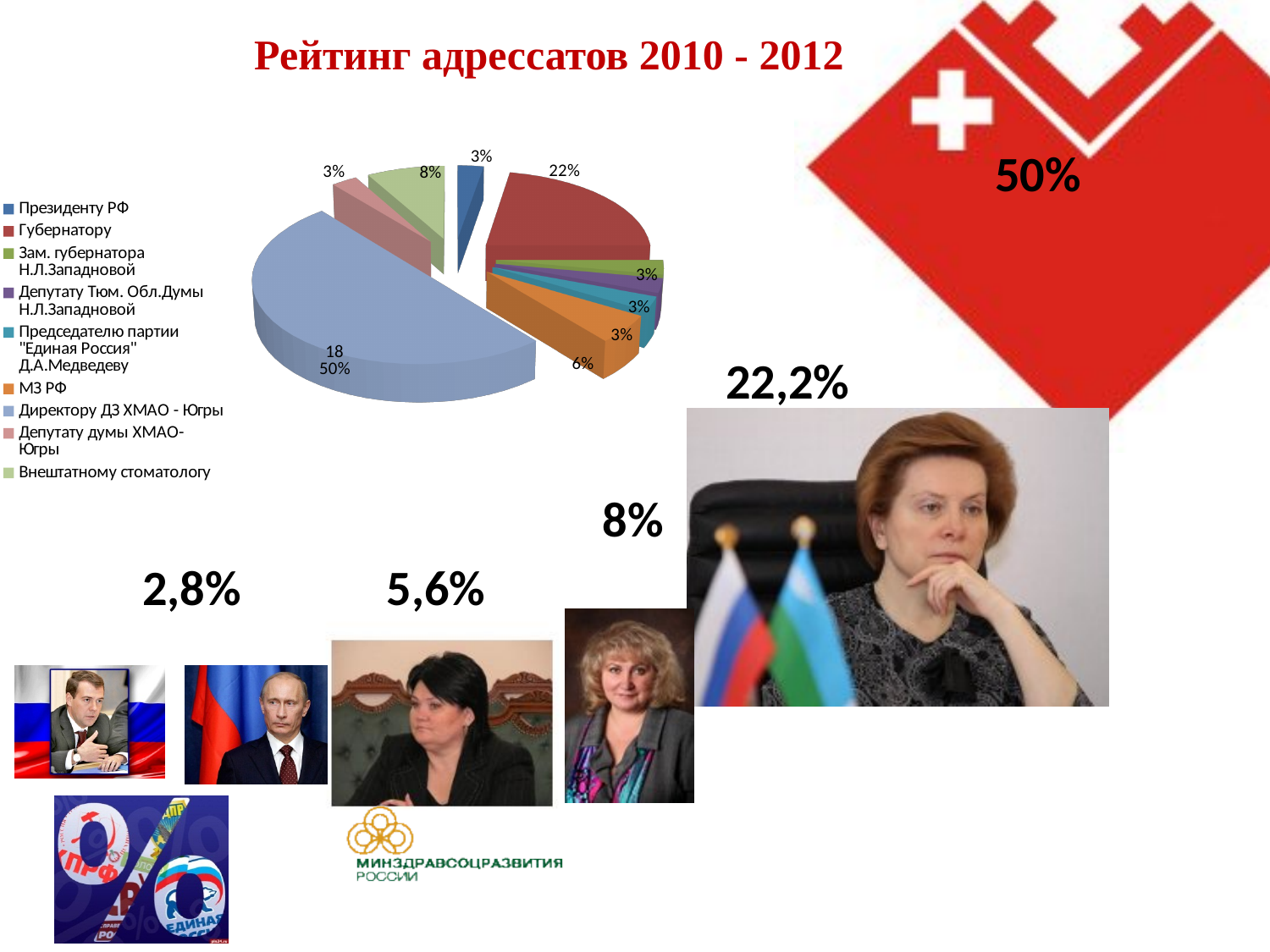
What is the title of the chart on the slide? Рейтинг адрессатов 2010 - 2012 What is the value shown for МЗ РФ in the pie chart? 6% How many categories does the legend of the pie chart list? 9 What is the value shown for Внештатному стоматологу in the pie chart? 8% What is the value shown for Губернатору in the pie chart? 22% Which slice is larger: Губернатору or МЗ РФ? Губернатору What percentage of the pie does the slice for Директору ДЗ ХМАО - Югры represent? 50% Which category has the largest slice of the pie chart? Директору ДЗ ХМАО - Югры How many slices in the pie chart are labelled 3%? 5 What is the difference in percentage points between the slices for Директору ДЗ ХМАО - Югры and Губернатору? 28 What kind of chart is shown on the slide? pie chart What is the value shown for Президенту РФ in the pie chart? 3%